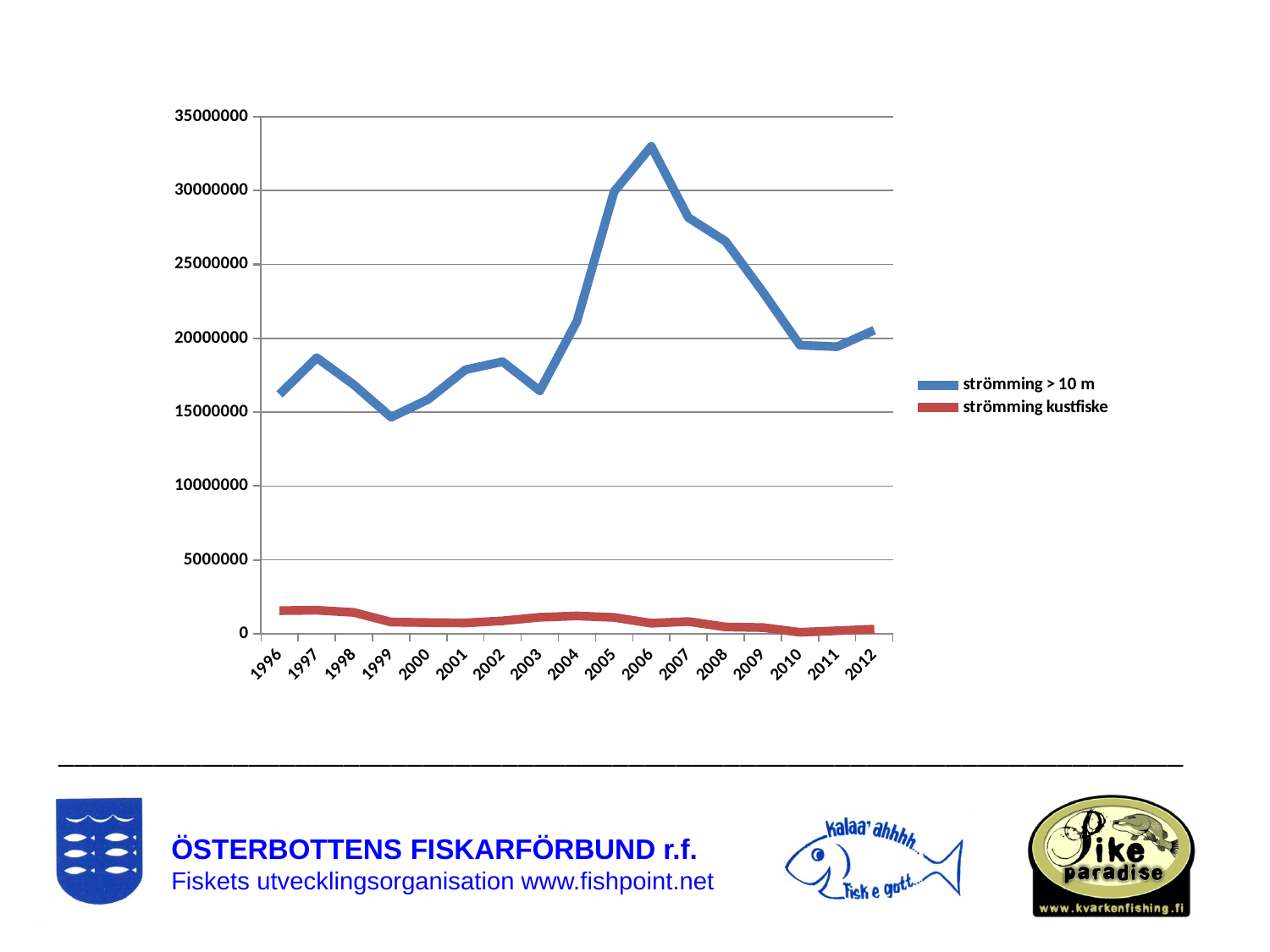
What kind of chart is shown on the slide? line chart Is the value for 'strömming > 10 m' in 2006 greater or less than 30000000? greater In which year does the 'strömming > 10 m' series reach its lowest value? 1999 Is the value for 'strömming kustfiske' in 2004 greater or less than 5000000? less Is the value for 'strömming > 10 m' in 2009 greater or less than 25000000? less Which is larger for 'strömming > 10 m': the value in 2006 or the value in 2010? 2006 Does the 'strömming > 10 m' series rise or fall from 2006 to 2010? fall Which colour represents 'strömming kustfiske' in the legend? red How many years are plotted along the x axis? 17 How many series does the legend list? 2 In which year does the 'strömming > 10 m' series reach its highest value? 2006